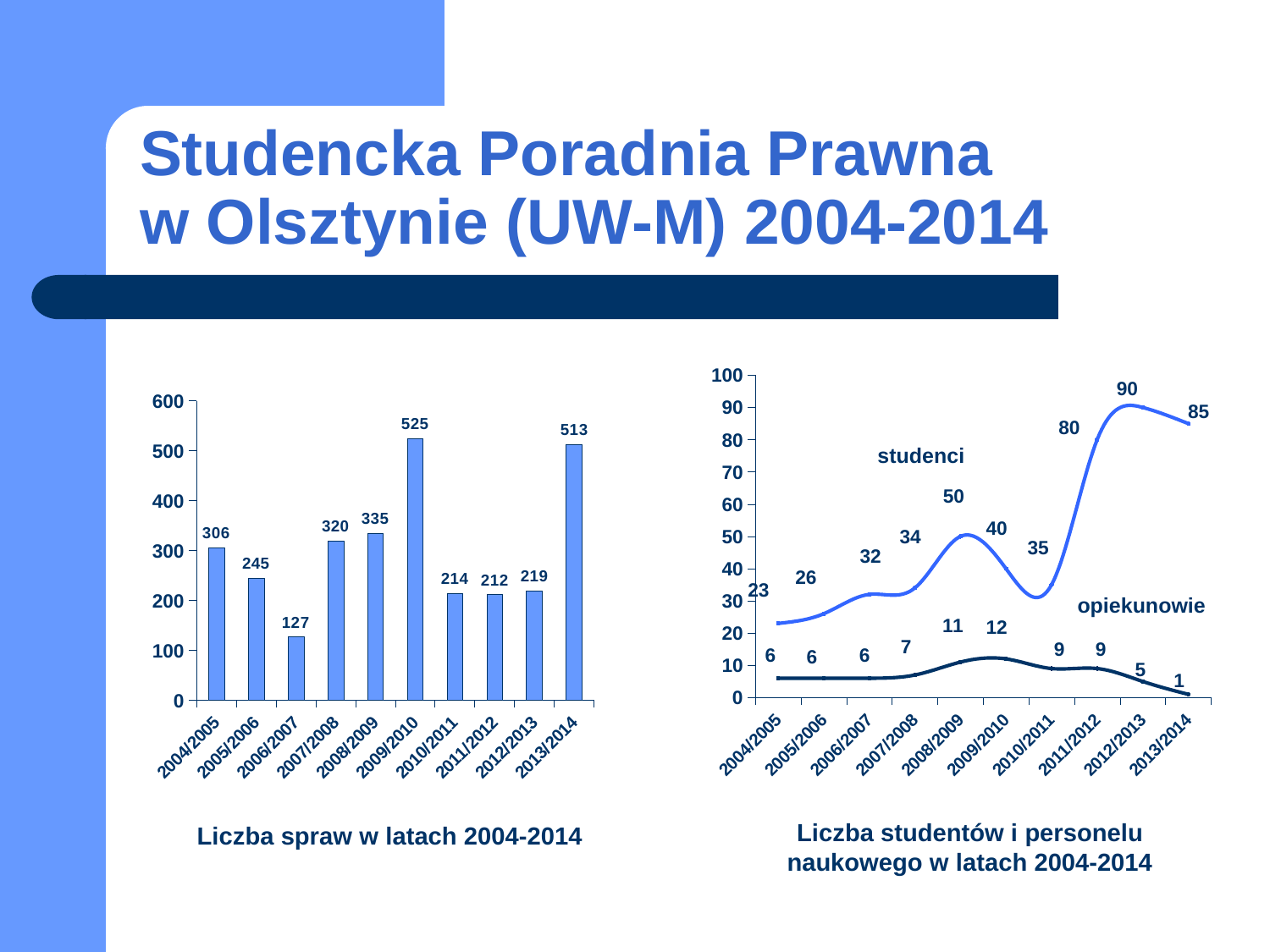
In the chart 'Liczba spraw w latach 2004-2014', which year has the lowest value? 2006/2007 What kind of chart is 'Liczba spraw w latach 2004-2014'? bar chart In the chart 'Liczba studentów i personelu naukowego w latach 2004-2014', in which year is the value for opiekunowie highest? 2009/2010 In the chart 'Liczba studentów i personelu naukowego w latach 2004-2014', what is the value for studenci in 2012/2013? 90 In the chart 'Liczba spraw w latach 2004-2014', which is larger: the value for 2004/2005 or the value for 2007/2008? 2007/2008 In the chart 'Liczba spraw w latach 2004-2014', what is the value for 2009/2010? 525 In the chart 'Liczba studentów i personelu naukowego w latach 2004-2014', what is the difference between studenci and opiekunowie in 2011/2012? 71 In the chart 'Liczba spraw w latach 2004-2014', what is the difference between the values for 2013/2014 and 2012/2013? 294 In the chart 'Liczba studentów i personelu naukowego w latach 2004-2014', what is the value for opiekunowie in 2013/2014? 1 In the chart 'Liczba spraw w latach 2004-2014', which year has the highest value? 2009/2010 How many years are shown on the x axis of the chart 'Liczba spraw w latach 2004-2014'? 10 What kind of chart is 'Liczba studentów i personelu naukowego w latach 2004-2014'? line chart